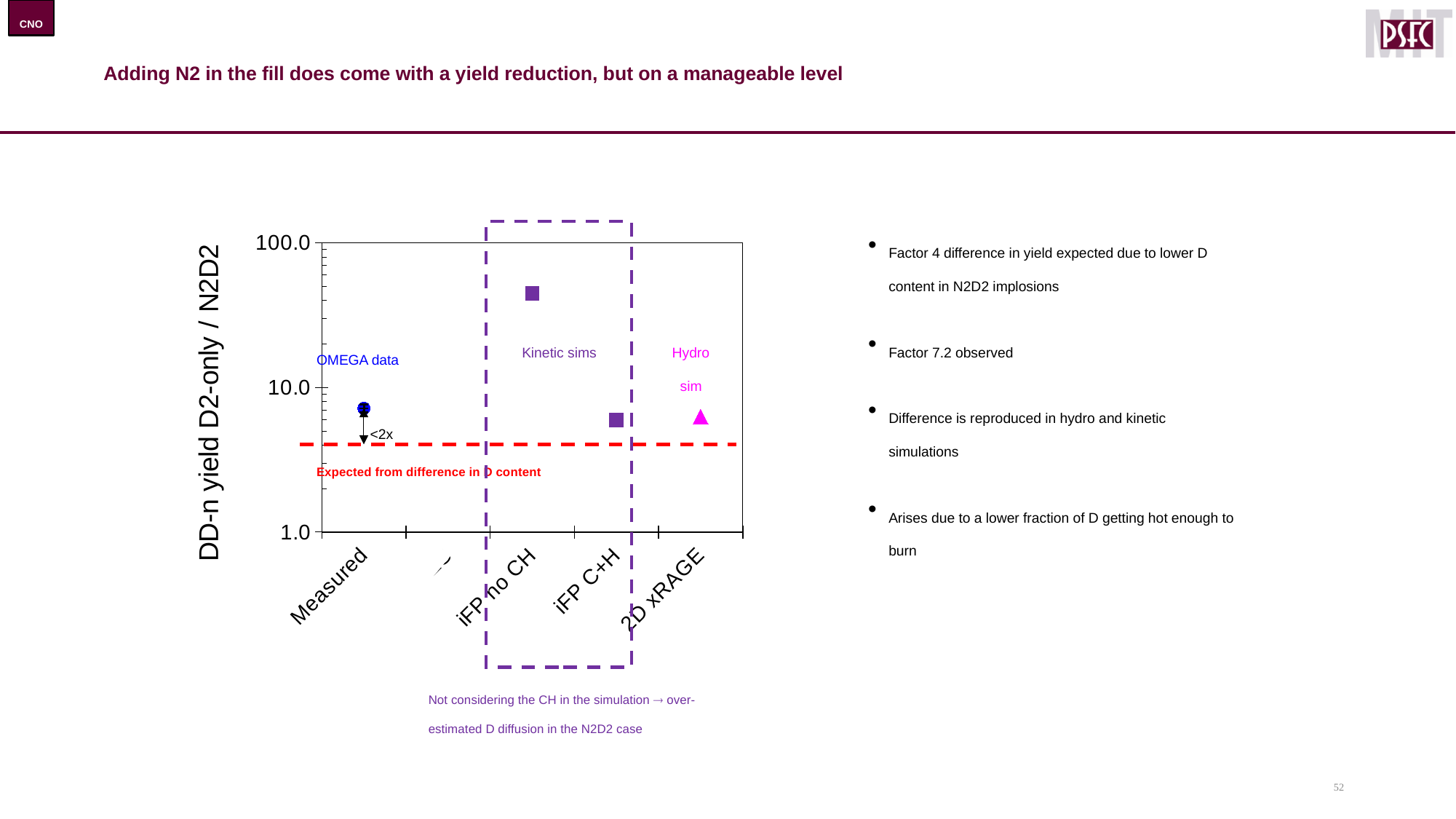
Is the value for iFP no CH greater or less than 10.0? greater Is the value for iFP no CH greater or less than 100.0? less What kind of chart is shown on the slide? scatter chart What is the title of the y axis? DD-n yield D2-only / N2D2 Which is larger, the value for iFP no CH or the value for Measured? iFP no CH Which is larger, the value for iFP no CH or the value for 2D xRAGE? iFP no CH Which category has the highest DD-n yield D2-only / N2D2 value? iFP no CH Is the value for Measured greater or less than 10.0? less How many data points are plotted on the chart? 4 What does the red dashed horizontal line represent, according to its label? Expected from difference in D content